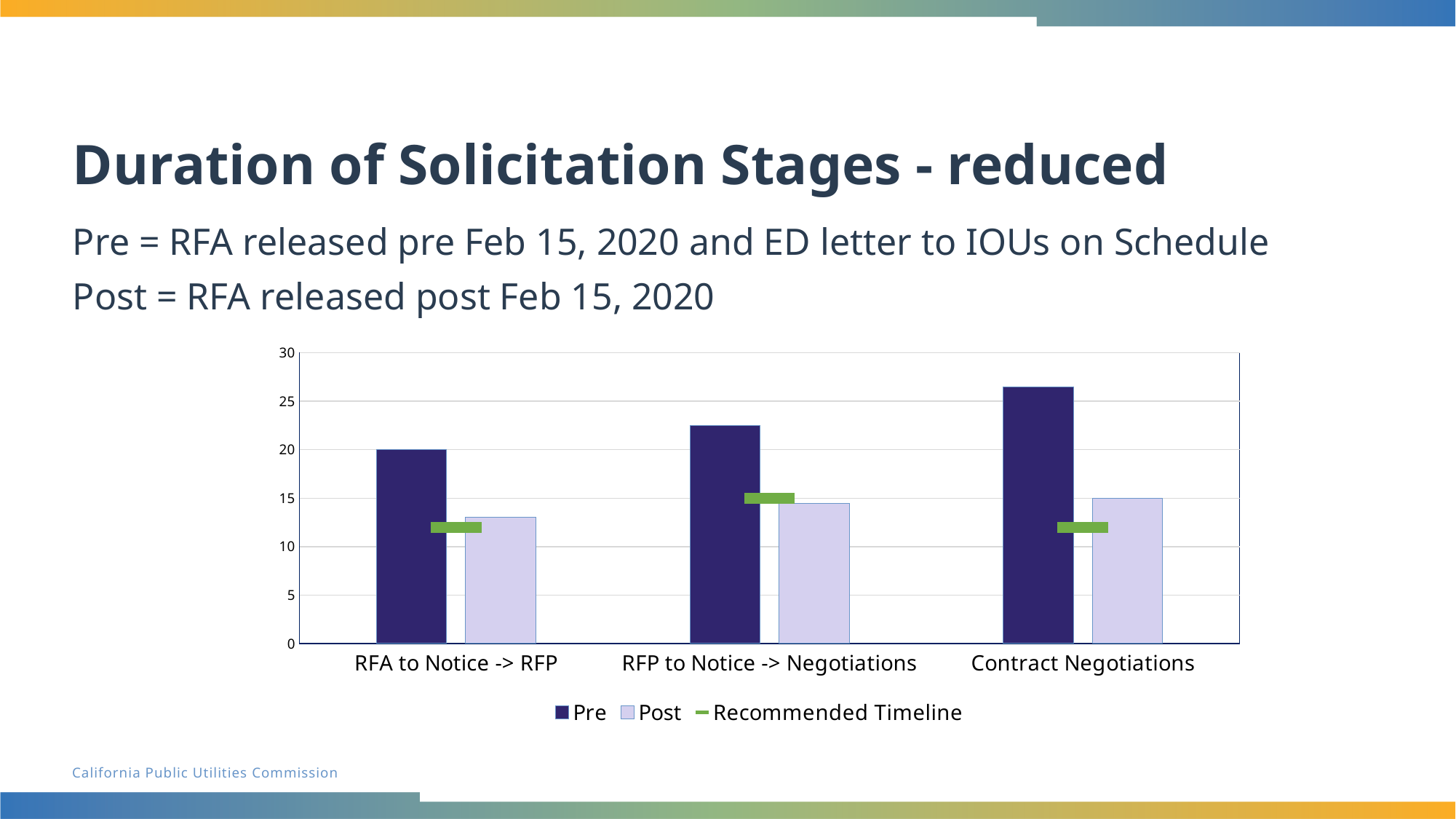
Is the Post value for RFP to Notice -> Negotiations greater or less than 10? greater Is the Pre value for RFP to Notice -> Negotiations greater or less than 20? greater For Contract Negotiations, which is larger, the Pre value or the Post value? Pre Which category has the lowest Pre value? RFA to Notice -> RFP Do the Pre values rise or fall moving left to right across the categories? rise Is the Post value for RFA to Notice -> RFP greater or less than 15? less Which series is shown as green markers in the chart? Recommended Timeline How many categories are shown on the x axis of the chart? 3 How many series does the chart legend list? 3 Which category has the highest Pre value? Contract Negotiations What kind of chart is shown on the slide? bar chart